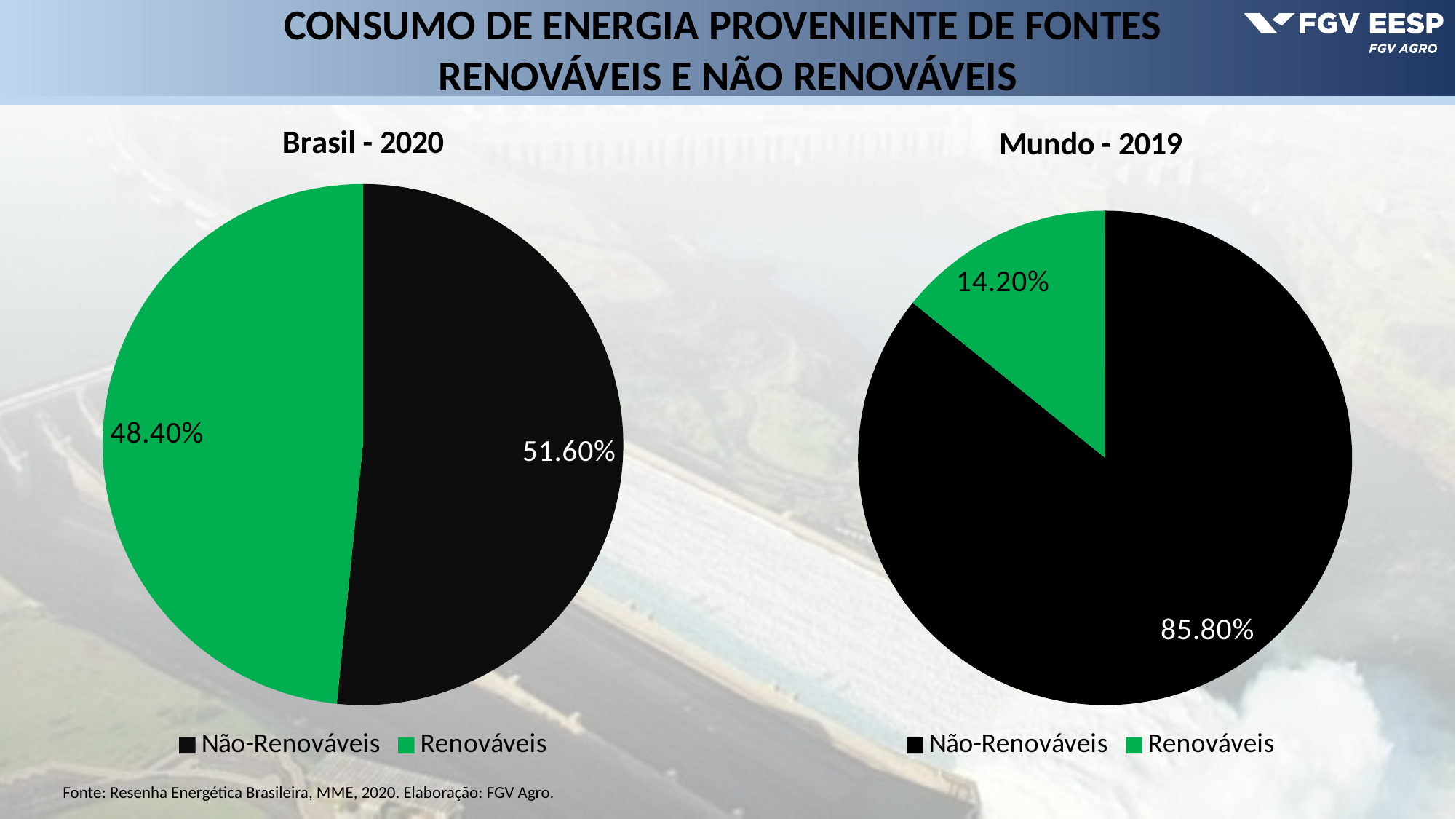
In the 'Brasil - 2020' chart, what share is Não-Renováveis? 51.60% In the 'Mundo - 2019' chart, which slice is the largest? Não-Renováveis In the 'Mundo - 2019' chart, what is the difference between the Não-Renováveis and Renováveis shares? 71.60% In the 'Brasil - 2020' chart, which slice is the smallest? Renováveis In the 'Mundo - 2019' chart, what share is Renováveis? 14.20% In the 'Brasil - 2020' chart, what share is Renováveis? 48.40% What kind of chart is the 'Brasil - 2020' chart? Pie chart In the 'Brasil - 2020' chart, what colour is the Renováveis slice? Green Which chart has the larger Renováveis share, 'Brasil - 2020' or 'Mundo - 2019'? Brasil - 2020 In the 'Brasil - 2020' chart, what is the difference between the Não-Renováveis and Renováveis shares? 3.20% In the 'Mundo - 2019' chart, what share is Não-Renováveis? 85.80% How many slices does the 'Mundo - 2019' chart have? 2